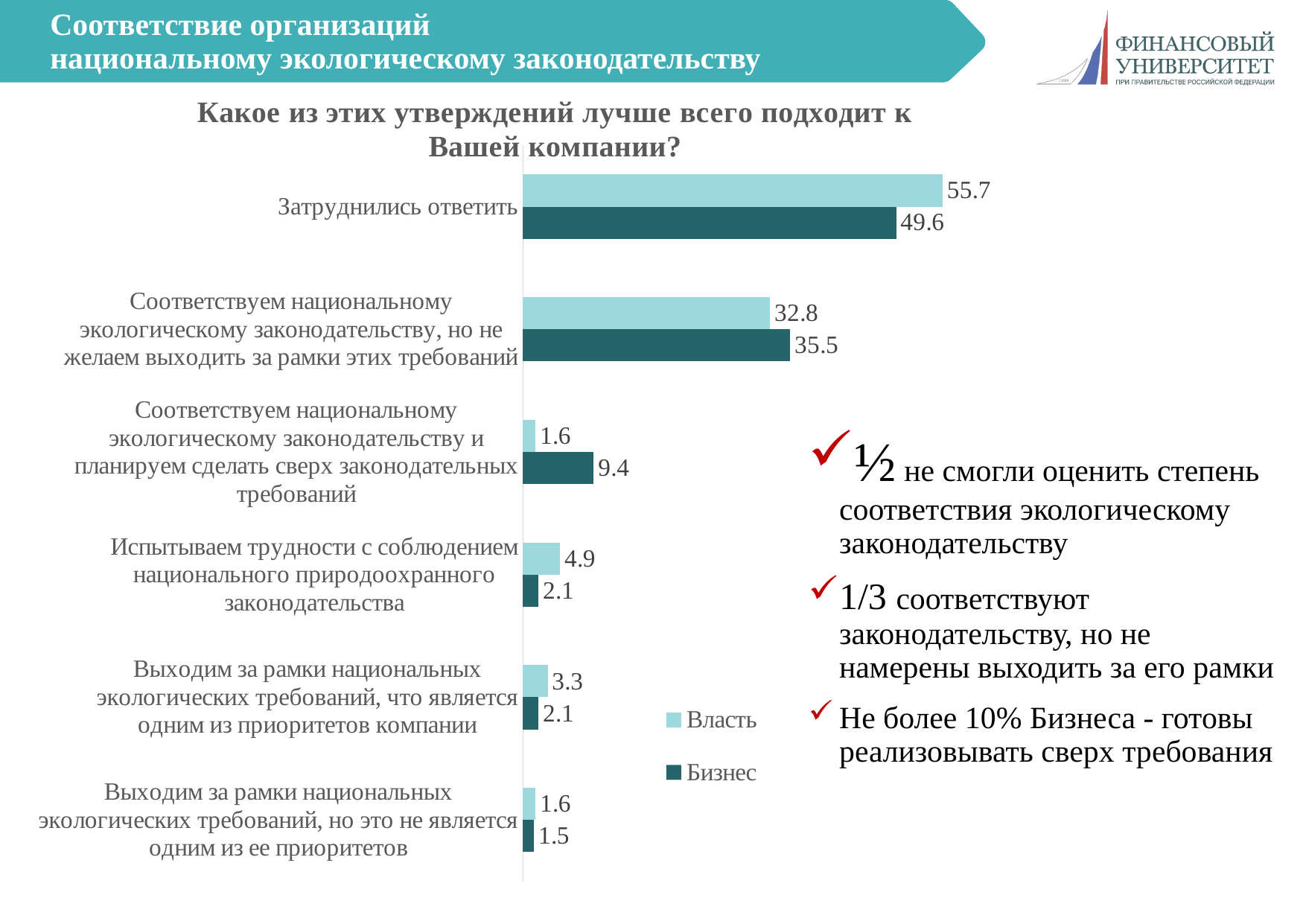
How many series does the legend list? 2 What is the value for "Бизнес" in the category "Соответствуем национальному экологическому законодательству и планируем сделать сверх законодательных требований"? 9.4 What is the value for "Власть" in the category "Испытываем трудности с соблюдением национального природоохранного законодательства"? 4.9 Which category has the highest value for the "Бизнес" series? Затруднились ответить What is the value for "Бизнес" in the "Затруднились ответить" category? 49.6 What is the difference between the "Власть" and "Бизнес" values in the "Затруднились ответить" category? 6.1 How many categories are shown on the chart? 6 In the category "Соответствуем национальному экологическому законодательству, но не желаем выходить за рамки этих требований", which series has the larger value, "Власть" or "Бизнес"? Бизнес What is the title of the chart? Какое из этих утверждений лучше всего подходит к Вашей компании? What kind of chart is shown on the slide? Bar chart What is the value for "Власть" in the "Затруднились ответить" category? 55.7 Which category has the lowest value for the "Бизнес" series? Выходим за рамки национальных экологических требований, но это не является одним из ее приоритетов